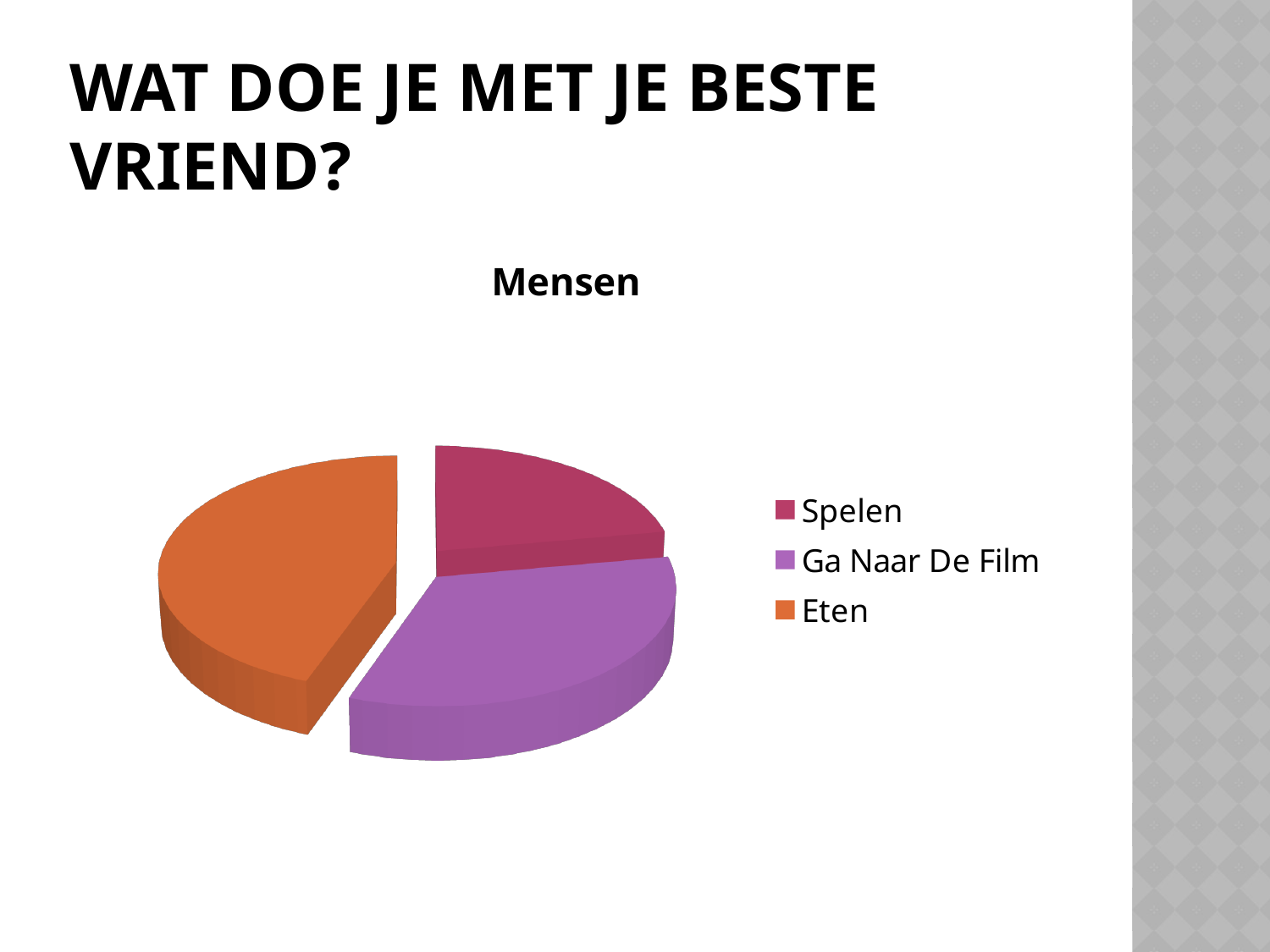
Which category has the smallest slice of the pie? Spelen How many entries does the legend list? 3 What is the title of the chart? Mensen Which category is shown in orange? Eten How many slices does the pie chart have? 3 What kind of chart is shown on the slide? pie chart Which slice is larger, Spelen or Ga Naar De Film? Ga Naar De Film Which slice is larger, Spelen or Eten? Eten